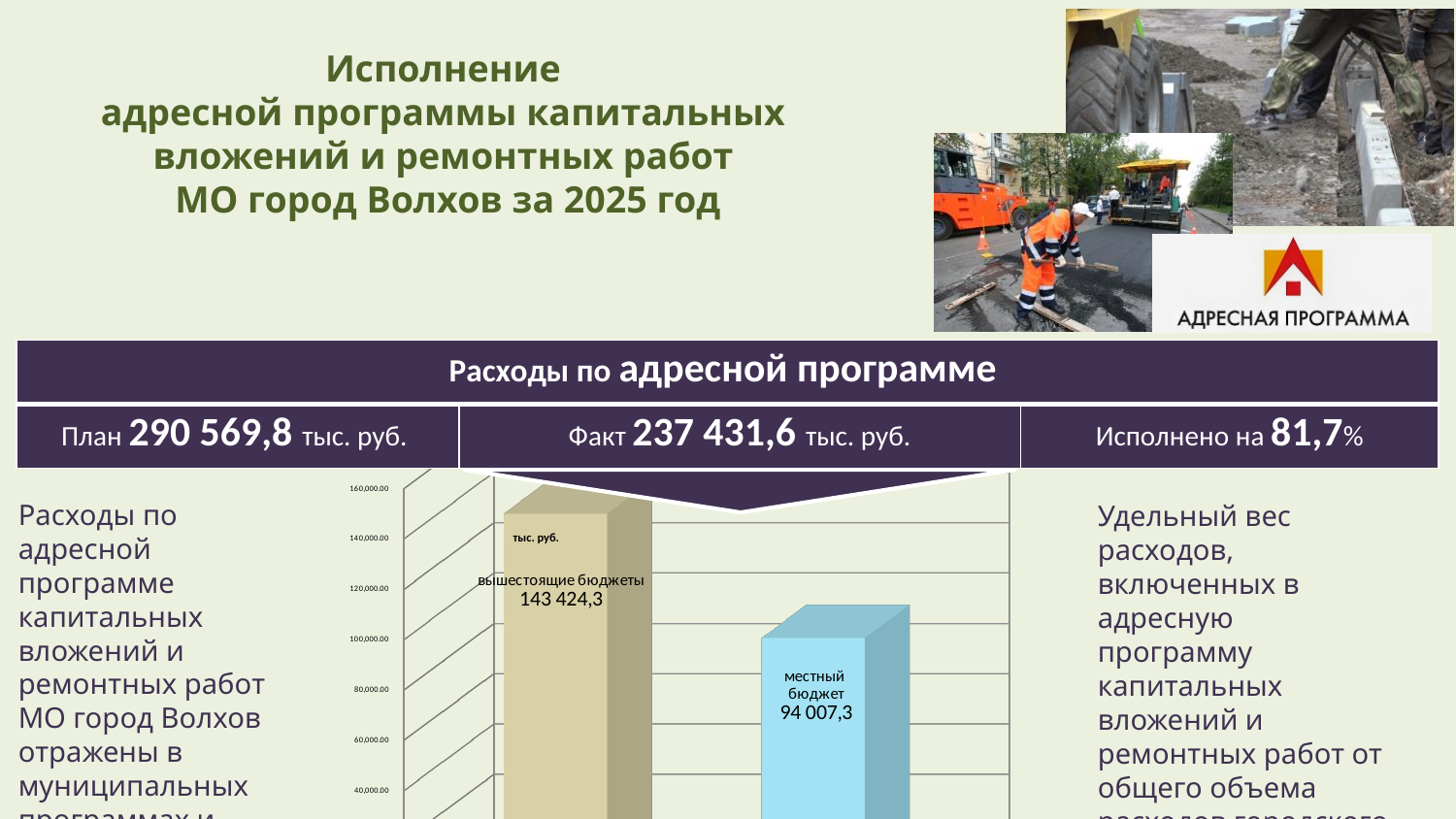
Which is larger: the value for вышестоящие бюджеты or the value for местный бюджет? вышестоящие бюджеты What is the difference between the values for вышестоящие бюджеты and местный бюджет? 49 417,0 Is the value for вышестоящие бюджеты greater or less than 120,000.00? greater Which category has the lowest value on the chart? местный бюджет What is the value for вышестоящие бюджеты on the chart? 143 424,3 Which category has the highest value on the chart? вышестоящие бюджеты What kind of chart is shown on the slide? bar chart What is the total of the two bars on the chart? 237 431,6 How many bars are plotted on the chart? 2 What is the value for местный бюджет on the chart? 94 007,3 Is the value for местный бюджет greater or less than 100,000.00? less What unit label is shown on the chart? тыс. руб.